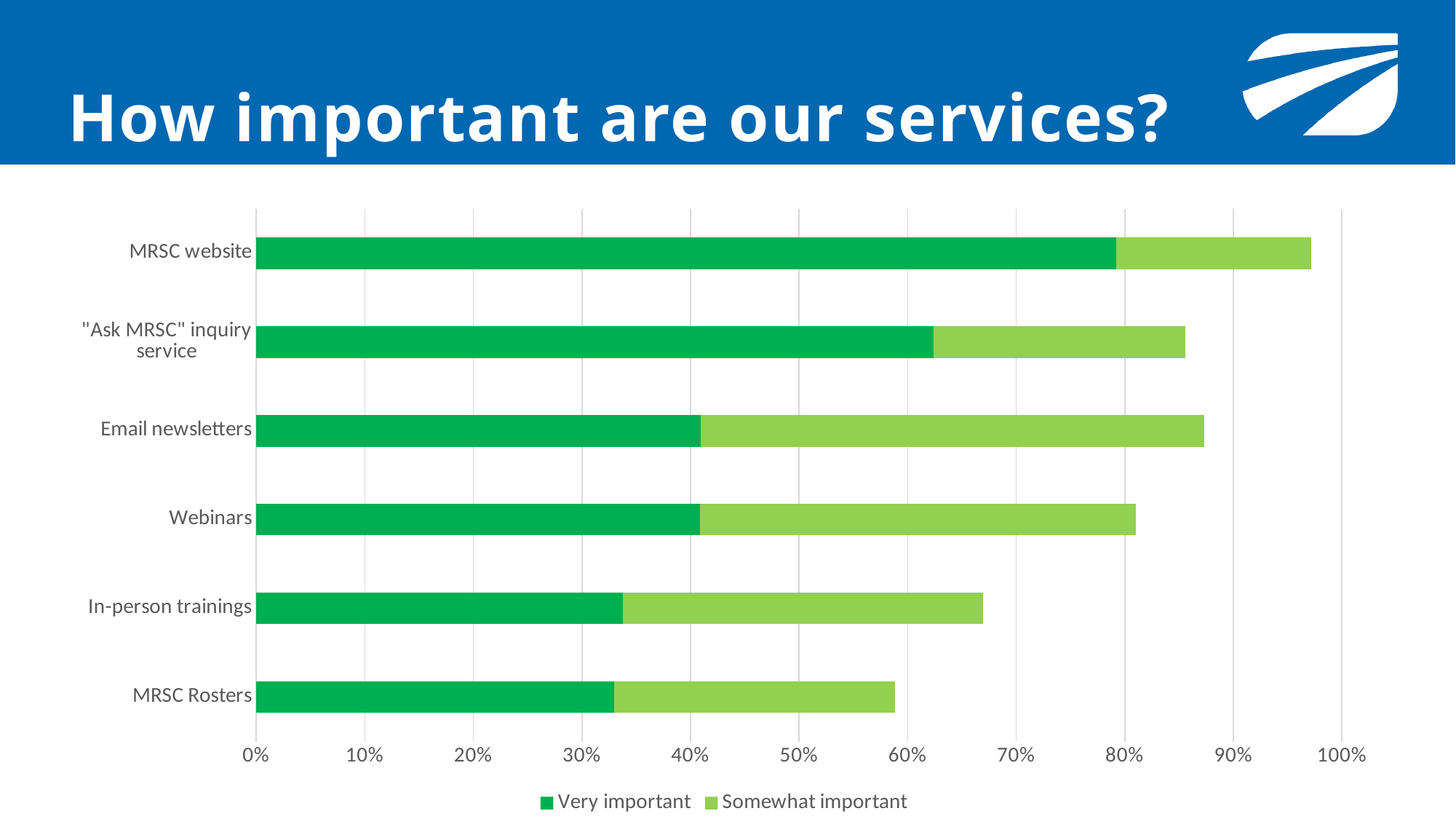
What kind of chart is shown on the slide? Bar chart Is the total bar for In-person trainings greater or less than 60%? greater Which service has the longest total bar (Very important plus Somewhat important)? MRSC website Which has the larger 'Very important' share: "Ask MRSC" inquiry service or Email newsletters? "Ask MRSC" inquiry service Which has the longer total bar: Email newsletters or Webinars? Email newsletters How many services (categories) are listed on the chart? 6 What are the two legend entries on the chart? Very important, Somewhat important Is the 'Very important' value for MRSC website greater or less than 70%? greater Which service has the shortest total bar (Very important plus Somewhat important)? MRSC Rosters How many series does the legend list? 2 Which service has the largest 'Very important' share? MRSC website Is the 'Very important' value for Email newsletters greater or less than 50%? less